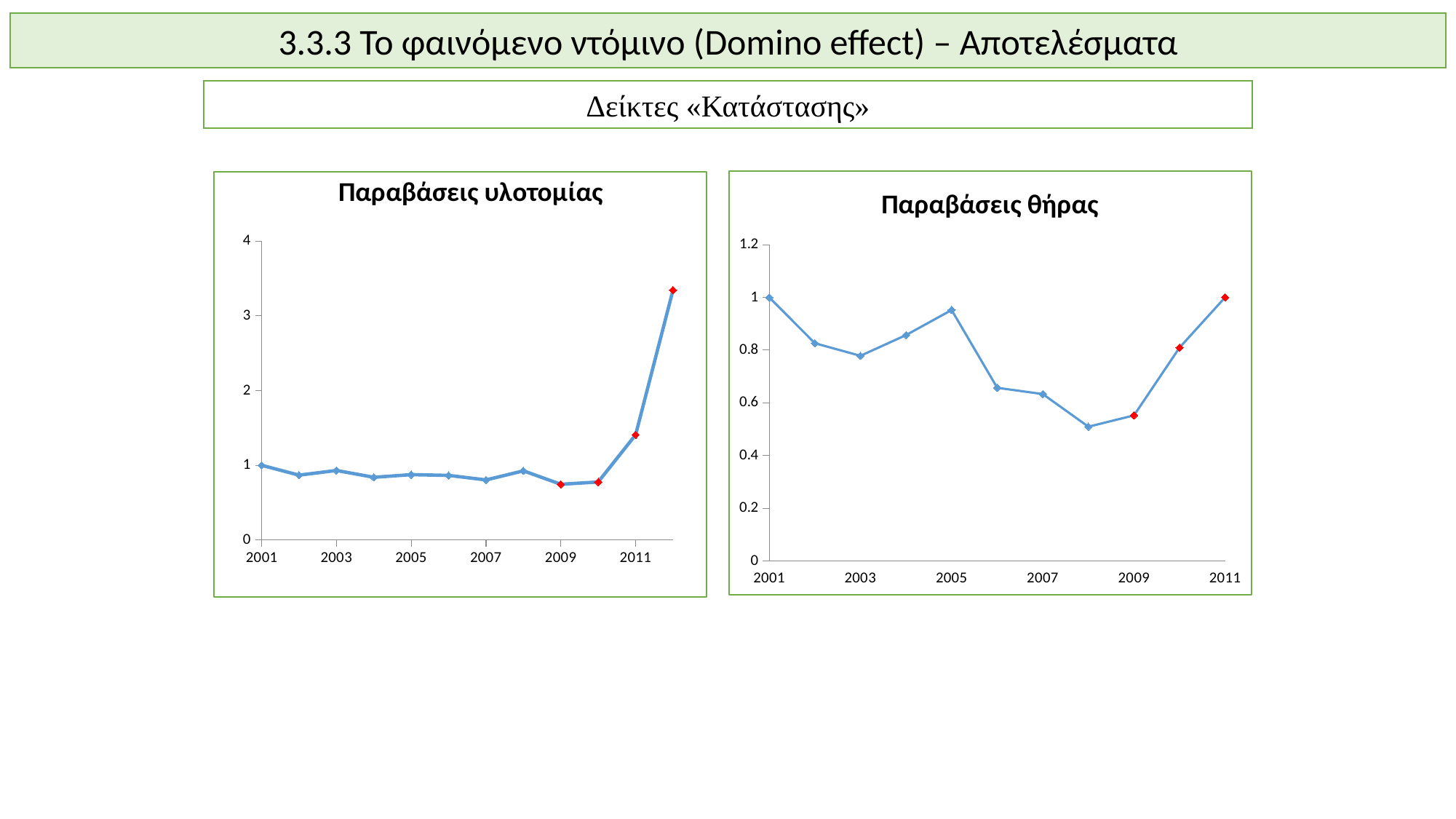
In the 'Παραβάσεις θήρας' chart, which is larger, the value for 2005 or the value for 2006? 2005 In the 'Παραβάσεις θήρας' chart, is the value for 2008 greater or less than 0.6? less In the 'Παραβάσεις υλοτομίας' chart, how many years are plotted on the x axis? 12 In the 'Παραβάσεις υλοτομίας' chart, what is the value for 2001? 1 In the 'Παραβάσεις υλοτομίας' chart, is the value for 2005 greater or less than 1? less In the 'Παραβάσεις υλοτομίας' chart, which year has the highest value? 2012 In the 'Παραβάσεις υλοτομίας' chart, do the values rise or fall from 2010 to 2012? rise What kind of chart is the 'Παραβάσεις υλοτομίας' chart on the left? line chart What is the title of the chart on the right of the slide? Παραβάσεις θήρας In the 'Παραβάσεις θήρας' chart, how many years are plotted on the x axis? 11 In the 'Παραβάσεις θήρας' chart, what is the value for 2011? 1 In the 'Παραβάσεις υλοτομίας' chart, is the value for 2012 greater or less than 3? greater